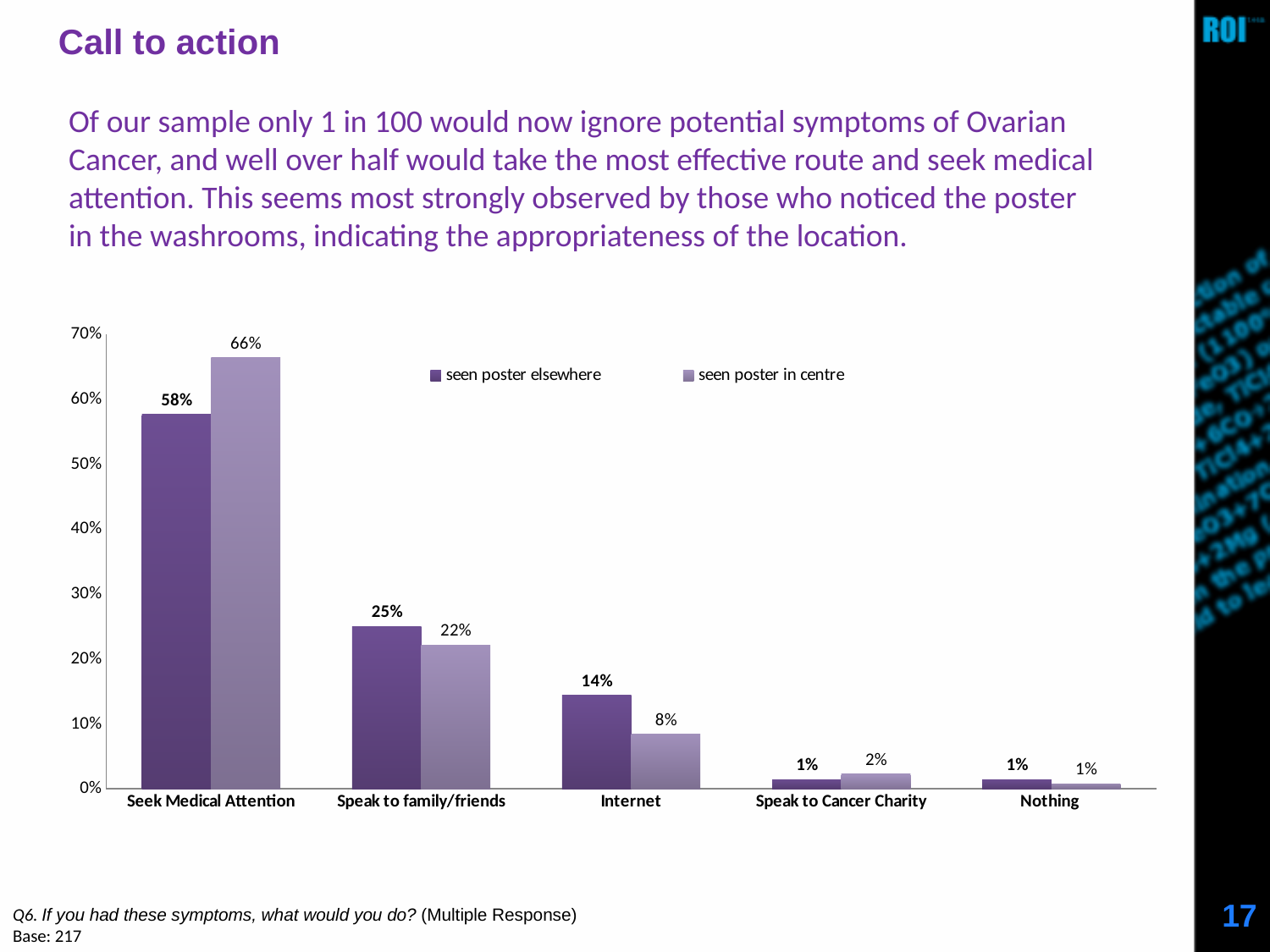
What is the value for 'seen poster in centre' for Seek Medical Attention? 66% What is the difference between 'seen poster elsewhere' and 'seen poster in centre' for Internet? 6% Which category has the highest value for 'seen poster elsewhere'? Seek Medical Attention Which category has the lowest value for 'seen poster in centre'? Nothing What is the value for 'seen poster elsewhere' for Speak to family/friends? 25% Do the values for 'seen poster elsewhere' rise or fall from left to right across the categories? fall What kind of chart is shown on the slide? bar chart How many categories are shown on the x axis? 5 How many series does the legend list? 2 What is the value for 'seen poster in centre' for Internet? 8% What is the difference between 'seen poster in centre' and 'seen poster elsewhere' for Seek Medical Attention? 8% For Speak to family/friends, which series has the larger value: 'seen poster elsewhere' or 'seen poster in centre'? seen poster elsewhere